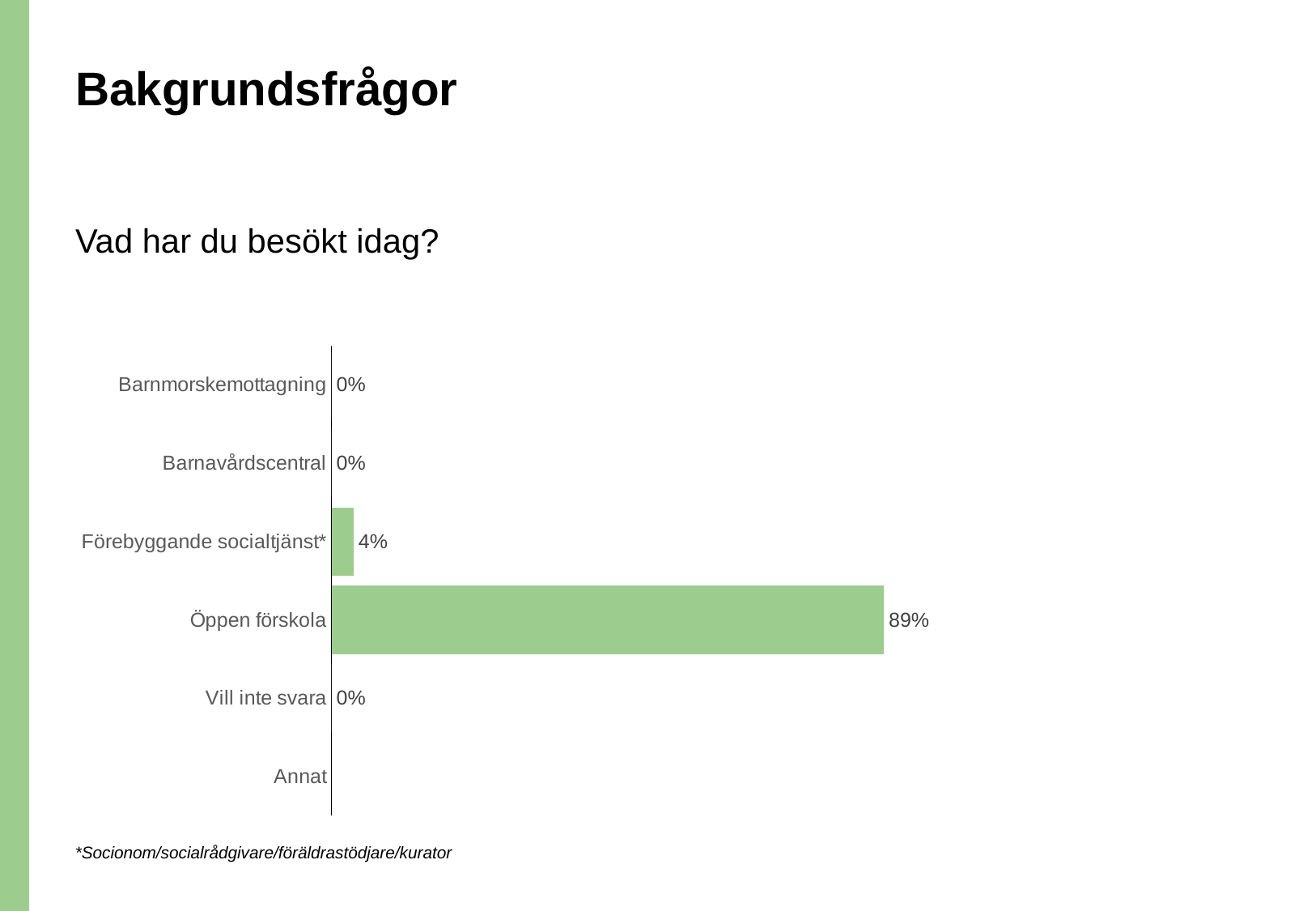
How many categories are shown on the chart? 6 What is the value for Barnavårdscentral? 0% What is the value for Barnmorskemottagning? 0% What kind of chart is shown on the slide? Bar chart Which category has the highest value? Öppen förskola What is the value for Vill inte svara? 0% What question does the chart answer, as written above it? Vad har du besökt idag? What colour are the bars in the chart? Green What is the value for Förebyggande socialtjänst*? 4% What is the value for Öppen förskola? 89% What is the difference between the values for Öppen förskola and Förebyggande socialtjänst*? 85 percentage points Which is larger, the value for Förebyggande socialtjänst* or the value for Barnavårdscentral? Förebyggande socialtjänst*